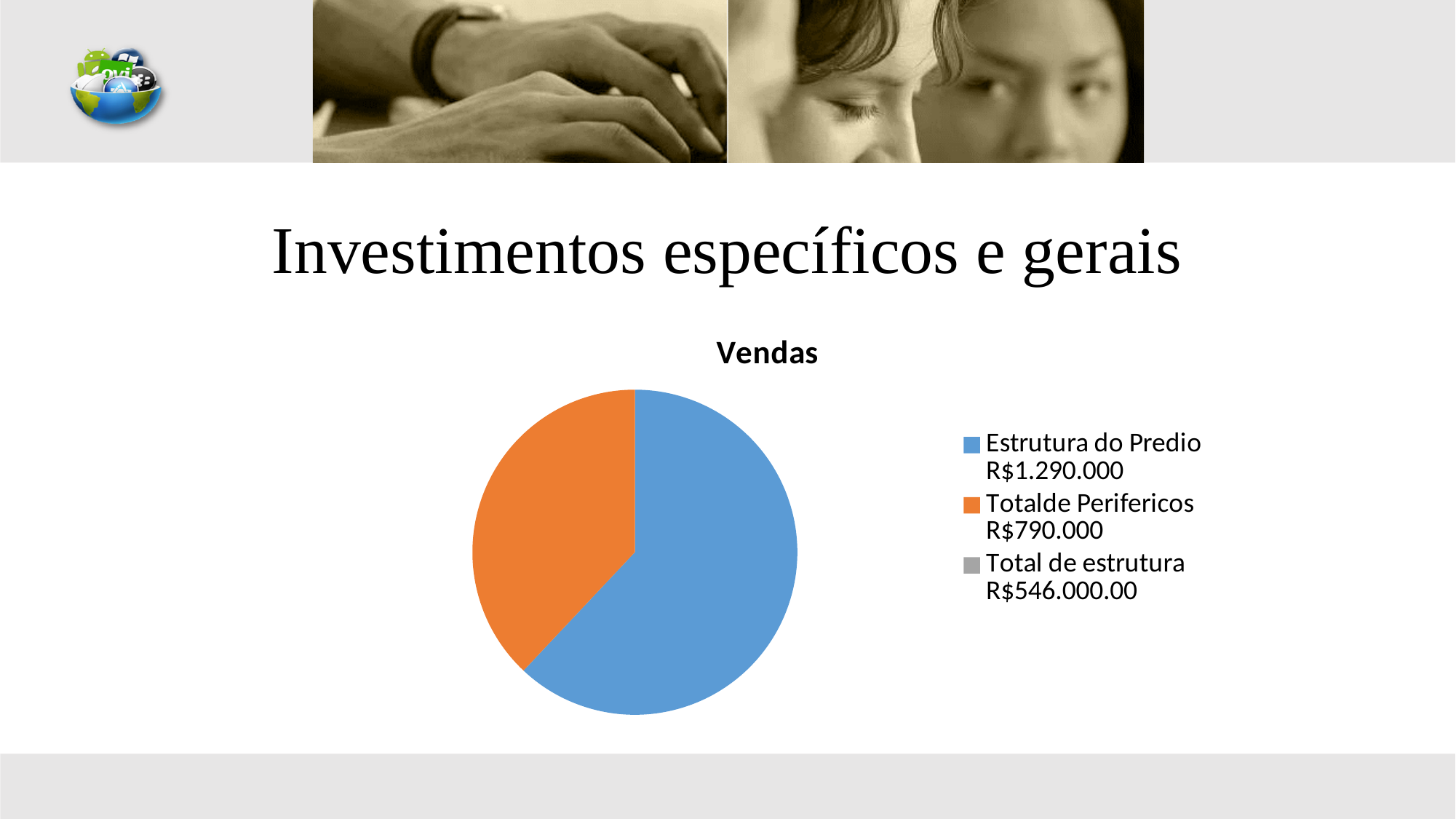
What value is shown in the legend for Totalde Perifericos? R$790.000 How many entries does the chart legend list? 3 Which legend entry has the smallest value? Total de estrutura What is the title of the chart? Vendas What is the difference between the values for Estrutura do Predio and Totalde Perifericos? R$500.000 What value is shown in the legend for Total de estrutura? R$546.000.00 What value is shown in the legend for Estrutura do Predio? R$1.290.000 Which category has the largest slice of the pie? Estrutura do Predio Which is larger, Estrutura do Predio or Totalde Perifericos? Estrutura do Predio What kind of chart is shown on the slide? pie chart What colour represents Estrutura do Predio in the pie chart? blue